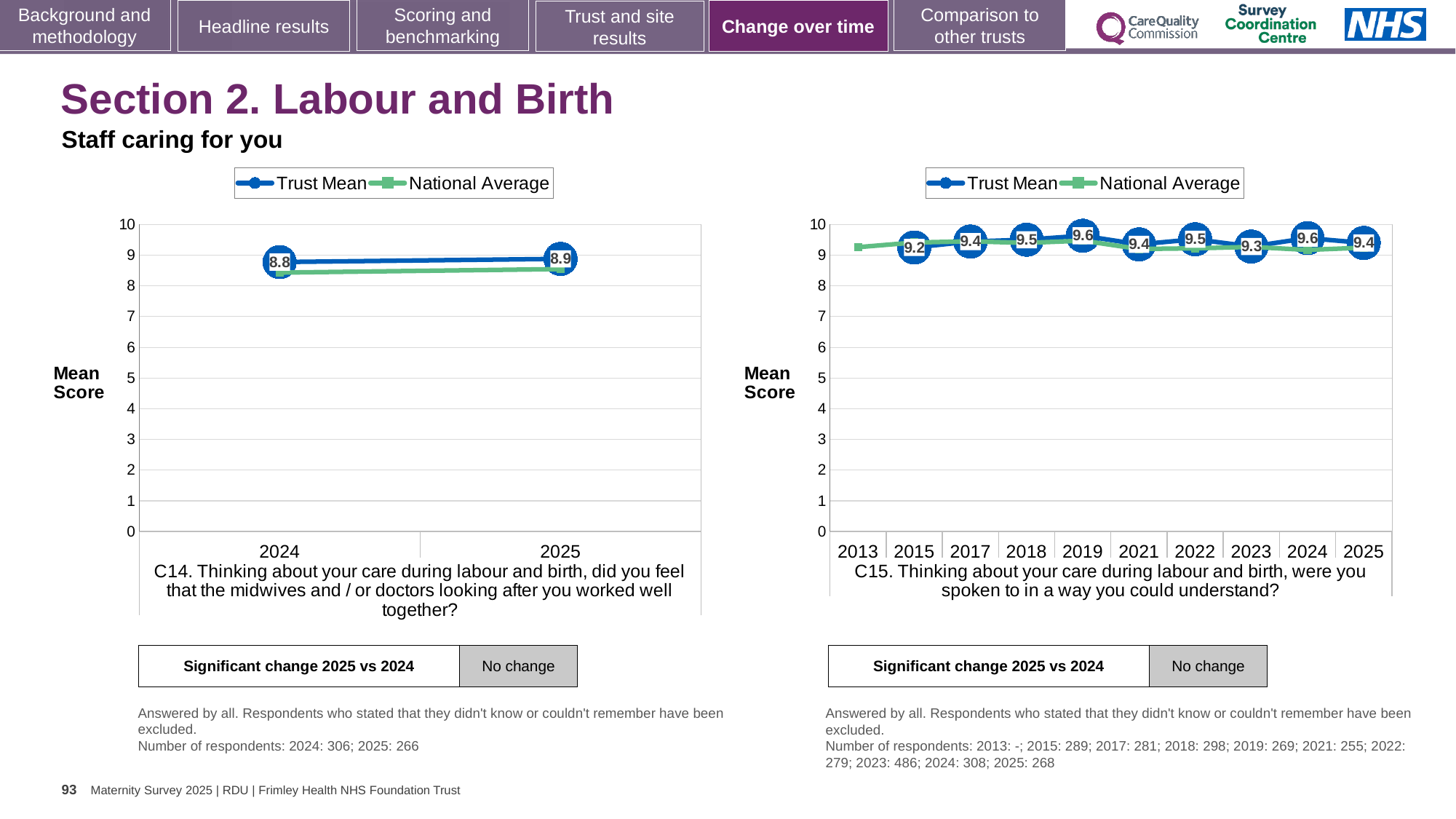
In the right chart (C15), what is the difference between the Trust Mean for 2024 and 2025? 0.2 In the right chart (C15), what is the Trust Mean for 2019? 9.6 In the right chart (C15), what is the Trust Mean for 2023? 9.3 What type of chart is the right chart (C15)? Line chart In the left chart (C14), what is the difference between the Trust Mean for 2025 and 2024? 0.1 In the right chart (C15), what is the Trust Mean for 2025? 9.4 In the left chart (C14), how many series does the legend list? 2 In the left chart (C14), is the National Average for 2024 greater or less than 8? greater In the right chart (C15), which year has the lowest labelled Trust Mean? 2015 In the left chart (C14), what is the Trust Mean for 2024? 8.8 In the left chart (C14), what is the Trust Mean for 2025? 8.9 In the right chart (C15), how many years are shown on the x axis? 10